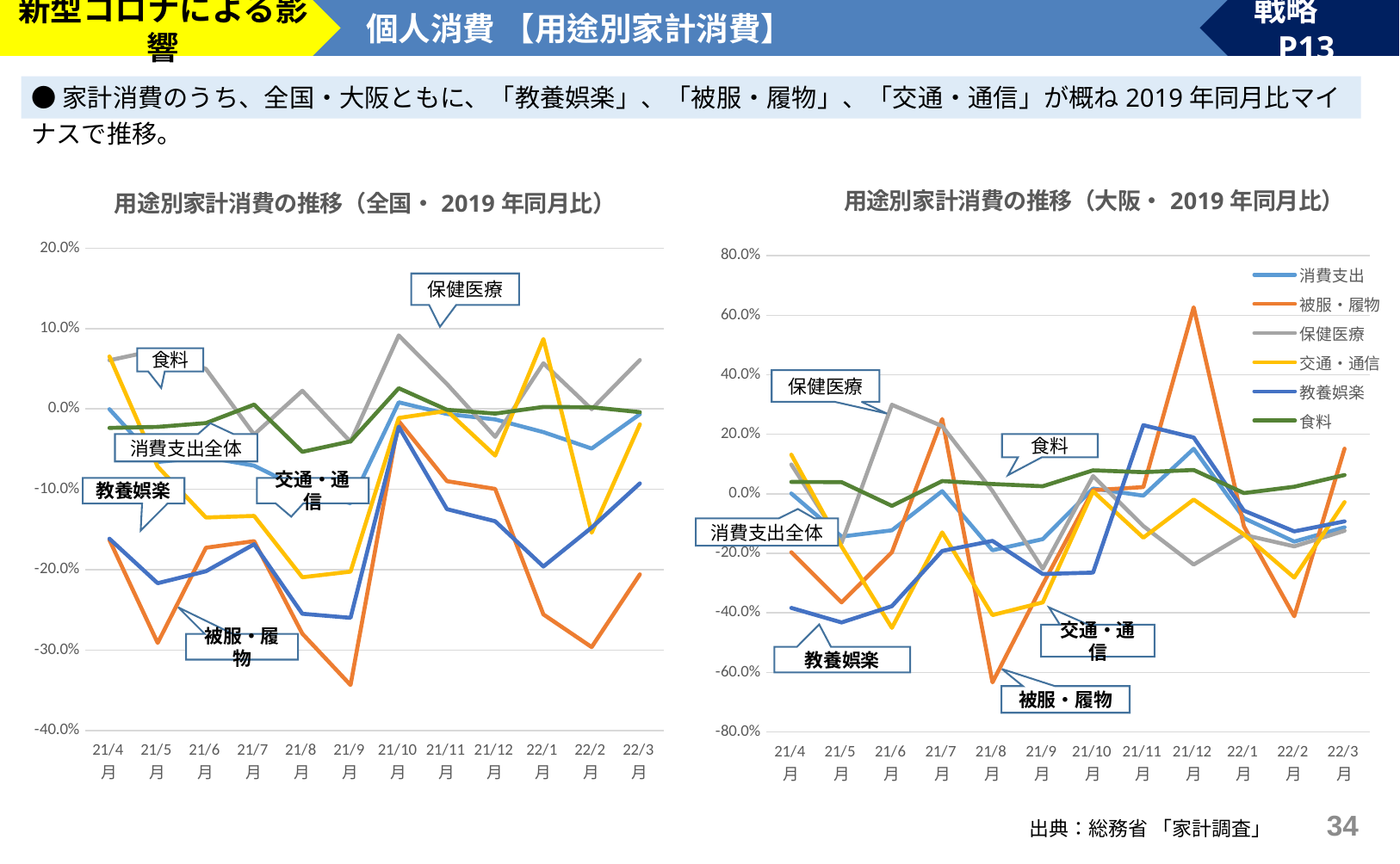
In the left chart (全国), which series has the lowest value at 21/9月? 被服・履物 In the left chart (全国), is the value for 被服・履物 at 21/9月 greater or less than -30.0%? less How many series does the legend of the right chart (大阪) list? 6 What kind of chart is the left chart titled 用途別家計消費の推移（全国・2019年同月比）? line chart In the right chart (大阪), is the value for 被服・履物 at 21/12月 greater or less than 60.0%? greater In the right chart (大阪), which series reaches the highest value on the chart? 被服・履物 In the right chart (大阪), at 21/6月, which is larger: 保健医療 or 食料? 保健医療 What source is cited at the bottom of the slide for the charts? 総務省「家計調査」 In the left chart (全国), at 21/9月, which is larger: 教養娯楽 or 交通・通信? 交通・通信 In the right chart (大阪), does the 被服・履物 line rise or fall from 21/12月 to 22/2月? fall How many months are plotted along the x axis of the left chart (全国)? 12 In the right chart (大阪), is the value for 被服・履物 at 21/8月 greater or less than -60.0%? less